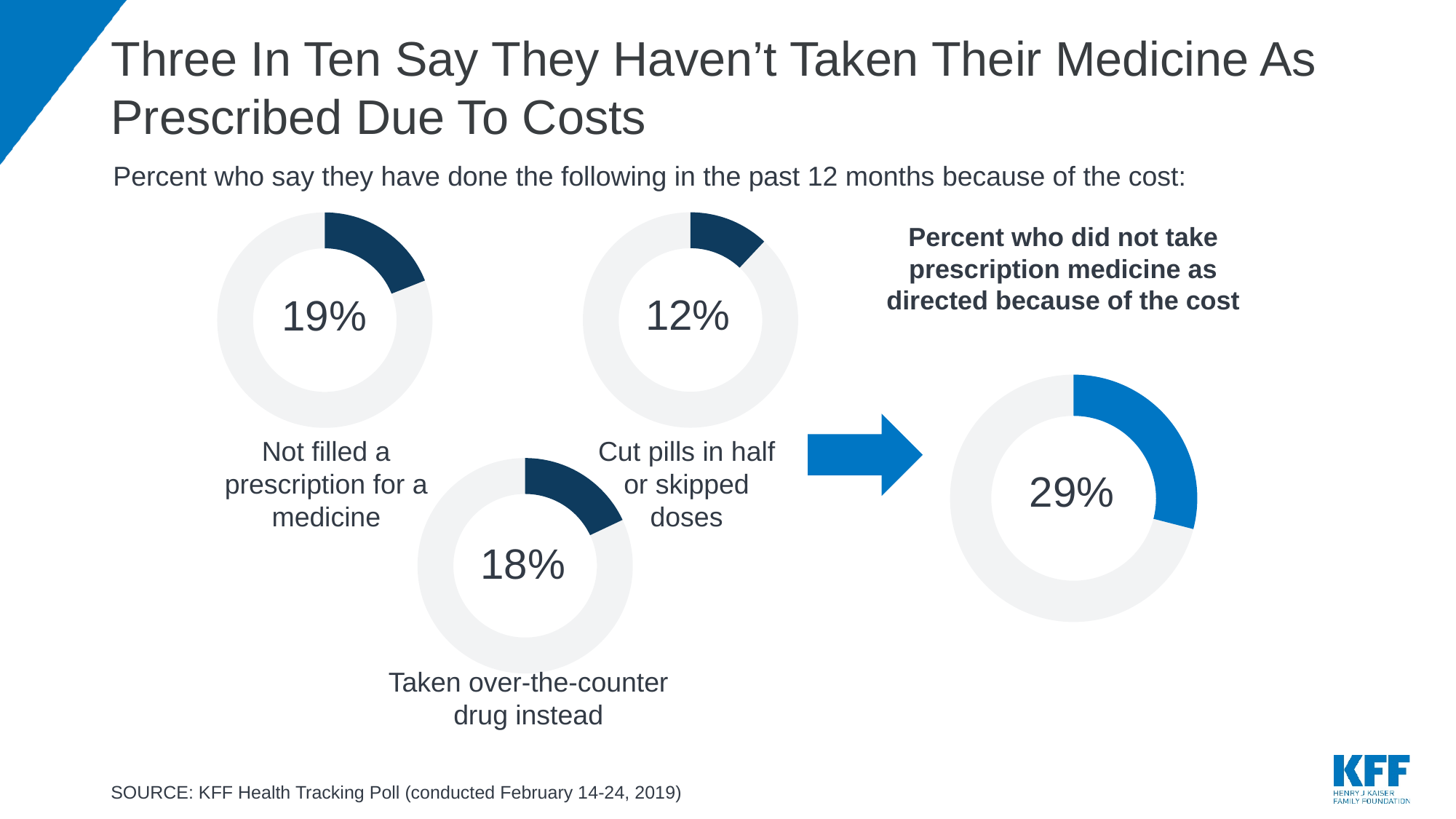
Among the three donut charts on the left (not filled a prescription, cut pills in half or skipped doses, taken over-the-counter drug instead), which action has the highest percent? Not filled a prescription for a medicine In the donut chart labeled "Not filled a prescription for a medicine", what percent is shown? 19% In the donut chart on the right titled "Percent who did not take prescription medicine as directed because of the cost", what percent is shown? 29% What is the difference in percentage points between the "Not filled a prescription for a medicine" chart and the "Cut pills in half or skipped doses" chart? 7 percentage points Which is larger: the percent in the "Taken over-the-counter drug instead" chart or the percent in the "Cut pills in half or skipped doses" chart? Taken over-the-counter drug instead What kind of chart is used to display the percentages on this slide? Donut chart Among the three donut charts on the left (not filled a prescription, cut pills in half or skipped doses, taken over-the-counter drug instead), which action has the lowest percent? Cut pills in half or skipped doses How many donut charts are shown on the slide? 4 What is the difference in percentage points between the right-hand chart (did not take prescription medicine as directed) and the "Taken over-the-counter drug instead" chart? 11 percentage points What colour is the filled segment of the right-hand donut chart showing 29%? Blue In the donut chart labeled "Taken over-the-counter drug instead", what percent is shown? 18% In the donut chart labeled "Cut pills in half or skipped doses", what percent is shown? 12%